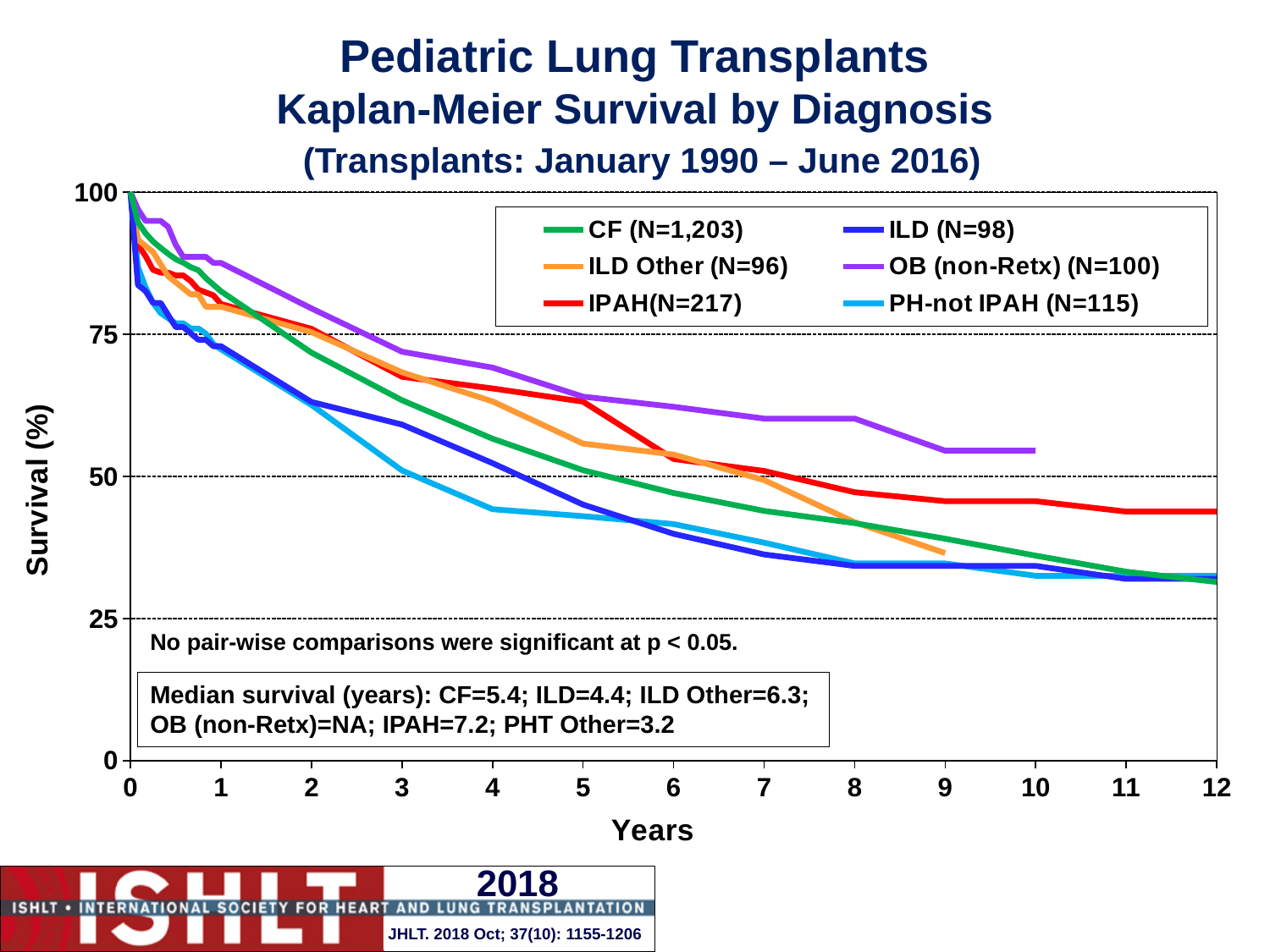
Is the survival for PH-not IPAH at 4 years greater or less than 50? less What kind of chart is shown on the slide? line chart Which series has the lowest survival at 3 years? PH-not IPAH Is the survival for OB (non-Retx) at 5 years greater or less than 50? greater At 6 years, which has higher survival, IPAH or ILD? IPAH What is the N for the IPAH series in the legend? 217 How many series does the legend list? 6 Is the survival for CF at 12 years greater or less than 50? less Which series has the highest survival at 8 years? OB (non-Retx) Do the survival curves rise or fall as years increase? fall According to the text box, what is the median survival in years for CF? 5.4 According to the text box, what is the median survival in years for ILD Other? 6.3